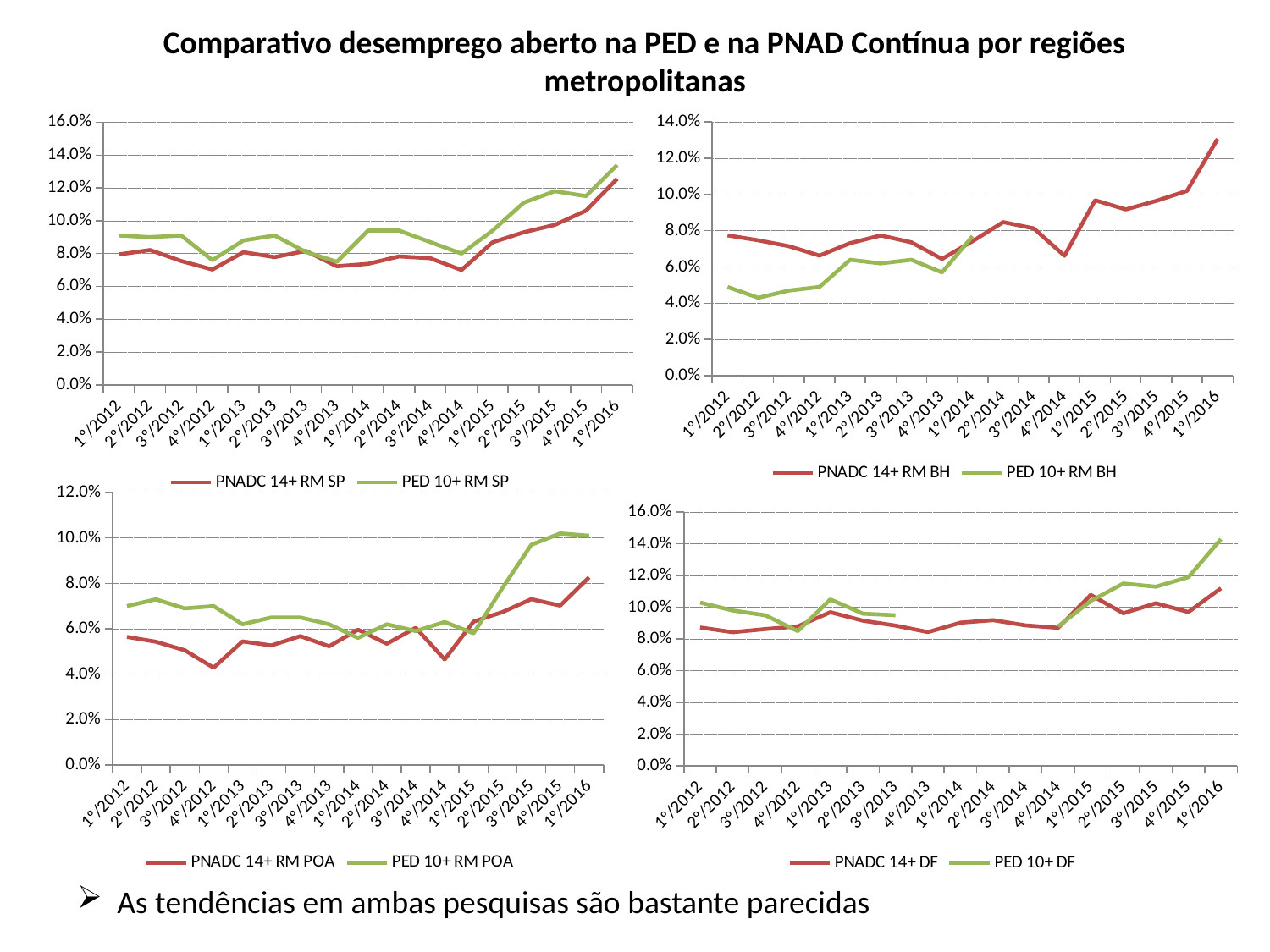
In the top-right chart (RM BH), is the value of PNADC 14+ RM BH at 1°/2016 greater or less than 12.0%? greater How many quarters are shown on the x axis of the top-right chart (RM BH)? 17 In the bottom-left chart (RM POA), which series has the higher value at 4°/2015, PNADC 14+ RM POA or PED 10+ RM POA? PED 10+ RM POA In the bottom-right chart (DF), is the value of PED 10+ DF at 1°/2016 greater or less than 12.0%? greater In the top-left chart (RM SP), is the value of PNADC 14+ RM SP at 4°/2012 greater or less than 8.0%? less How many series does the legend of the bottom-right chart (DF) list? 2 In the top-right chart (RM BH), at which quarter does PNADC 14+ RM BH reach its highest value? 1°/2016 What kind of chart is the top-left chart (RM SP)? Line chart In the top-right chart (RM BH), does the PNADC 14+ RM BH series overall rise or fall from 1°/2012 to 1°/2016? Rise